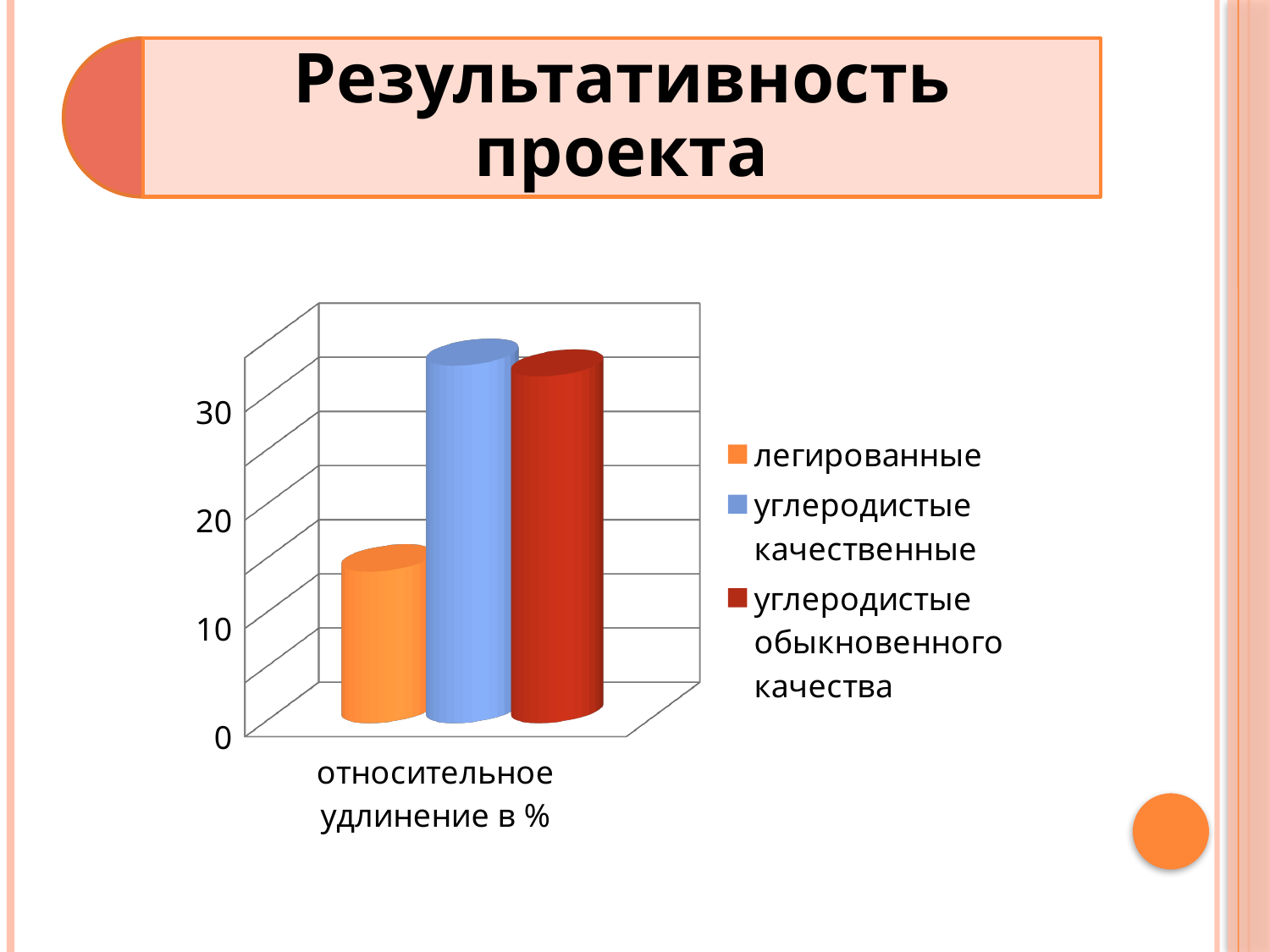
Is the value for углеродистые обыкновенного качества greater or less than 30? greater What is the category label on the x axis? относительное удлинение в % How many categories are shown on the x axis? 1 Is the value for углеродистые качественные greater or less than 30? greater What colour represents the series легированные in the legend? orange Which is larger, the value for легированные or the value for углеродистые обыкновенного качества? углеродистые обыкновенного качества Which is larger, the value for легированные or the value for углеродистые качественные? углеродистые качественные Which series has the lowest value for относительное удлинение в %? легированные How many series does the legend list? 3 Is the value for легированные greater or less than 20? less What kind of chart is shown on the slide? bar chart